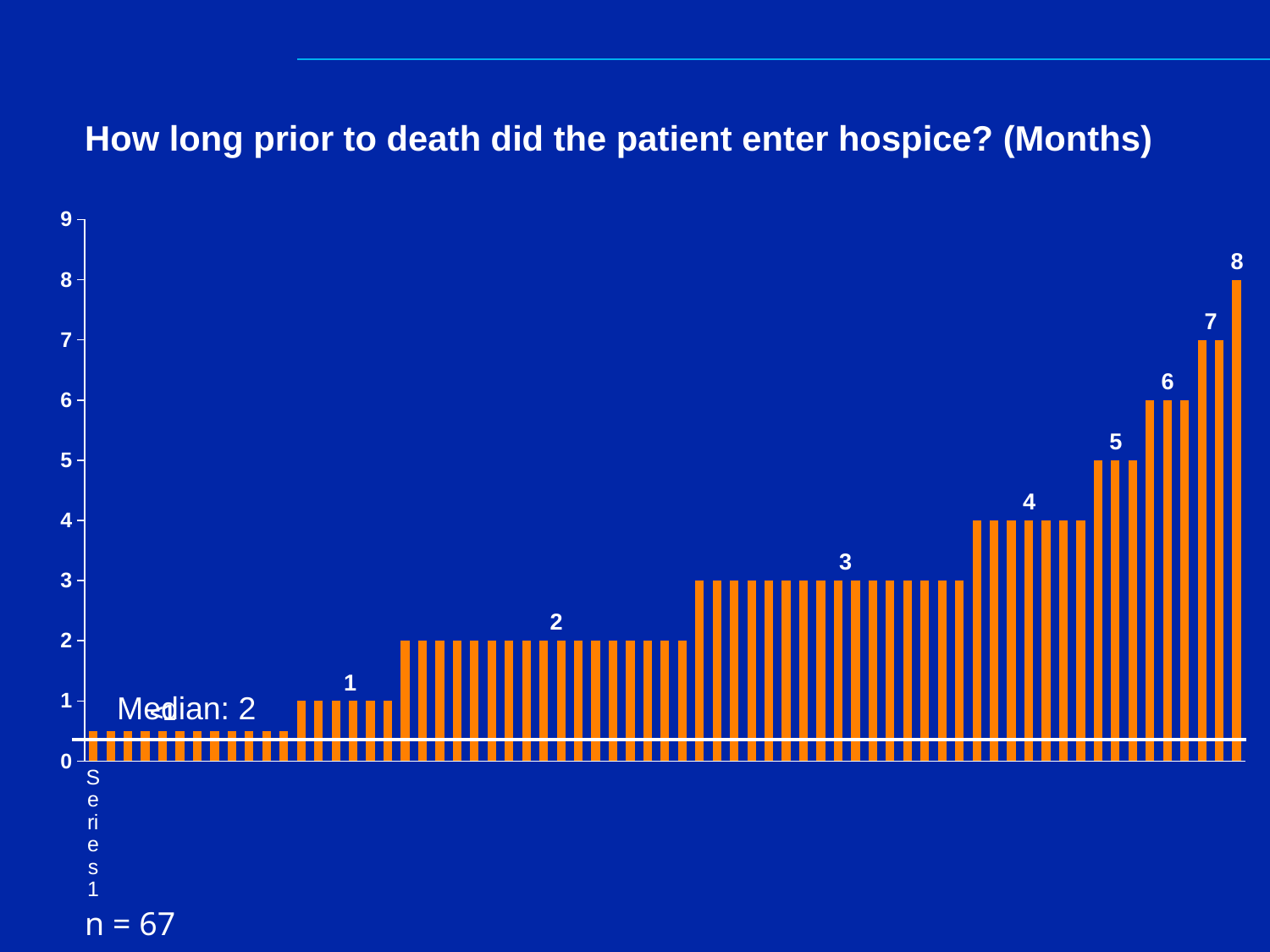
Which is larger, the bar labelled 8 or the bars labelled 6? the bar labelled 8 What is the highest tick value shown on the y axis? 9 What is the highest value shown by any bar in the chart? 8 How many bars reach the value 7? 2 Is the tallest bar greater or less than 7? greater What median value is printed on the chart? 2 How many bars reach the value 8? 1 What kind of chart is shown on the slide? bar chart What is the title of the chart? How long prior to death did the patient enter hospice? (Months) What sample size (n) is printed below the chart? 67 Do the bar values rise or fall from left to right along the x axis? rise What is the difference between the tallest bar (8) and the bars labelled 7? 1